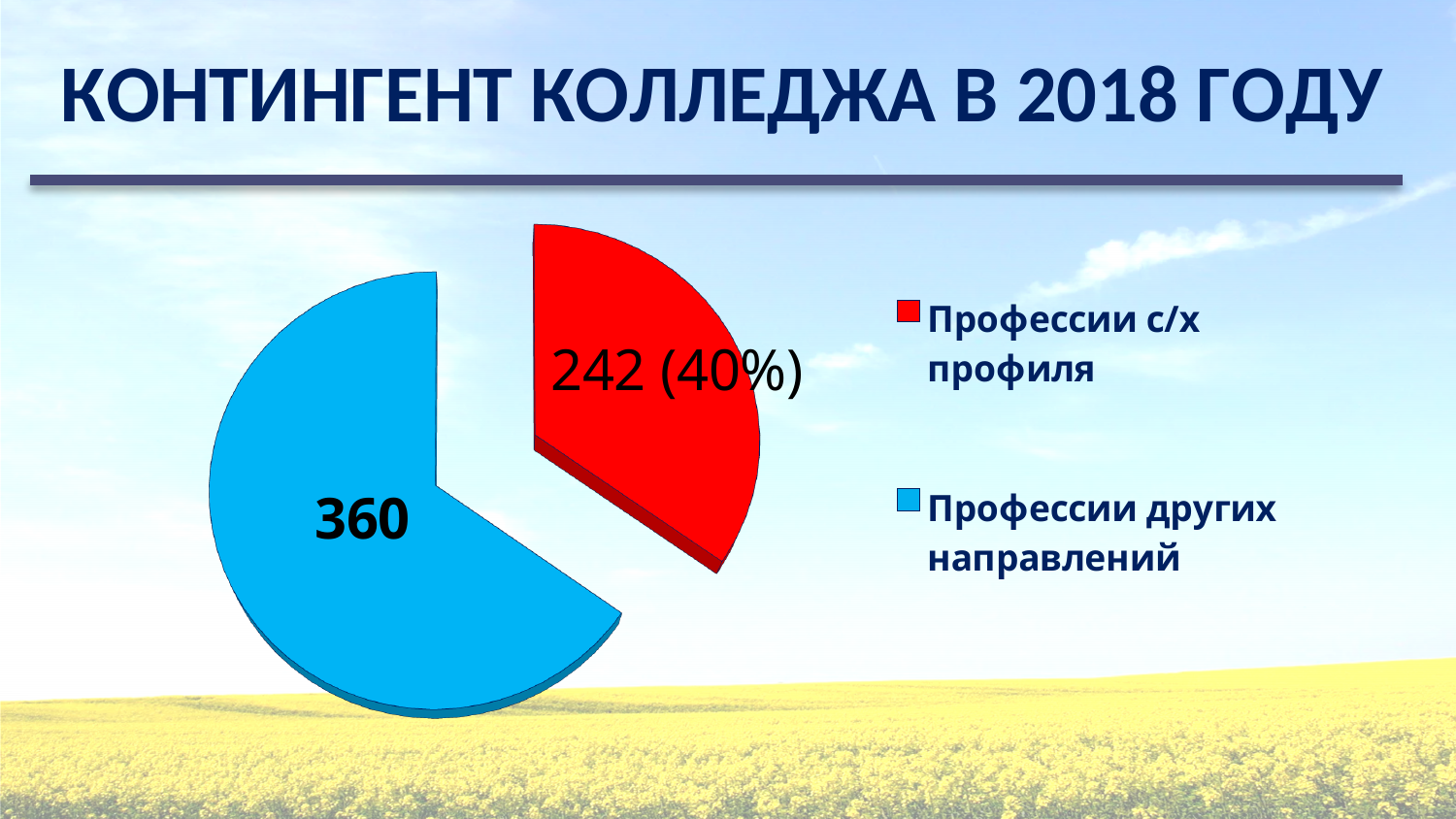
Which is larger: the value for "Профессии с/х профиля" or for "Профессии других направлений"? Профессии других направлений How many slices does the pie chart have? 2 What share of the pie does "Профессии с/х профиля" represent? 40% What is the difference between the values for "Профессии других направлений" and "Профессии с/х профиля"? 118 What is the title of the chart on the slide? КОНТИНГЕНТ КОЛЛЕДЖА В 2018 ГОДУ Which category has the largest slice of the pie? Профессии других направлений Which category has the smallest slice of the pie? Профессии с/х профиля What colour is the slice for "Профессии с/х профиля"? red What is the value for "Профессии других направлений"? 360 What kind of chart is shown on the slide? pie chart What is the value for "Профессии с/х профиля"? 242 How many entries does the legend list? 2